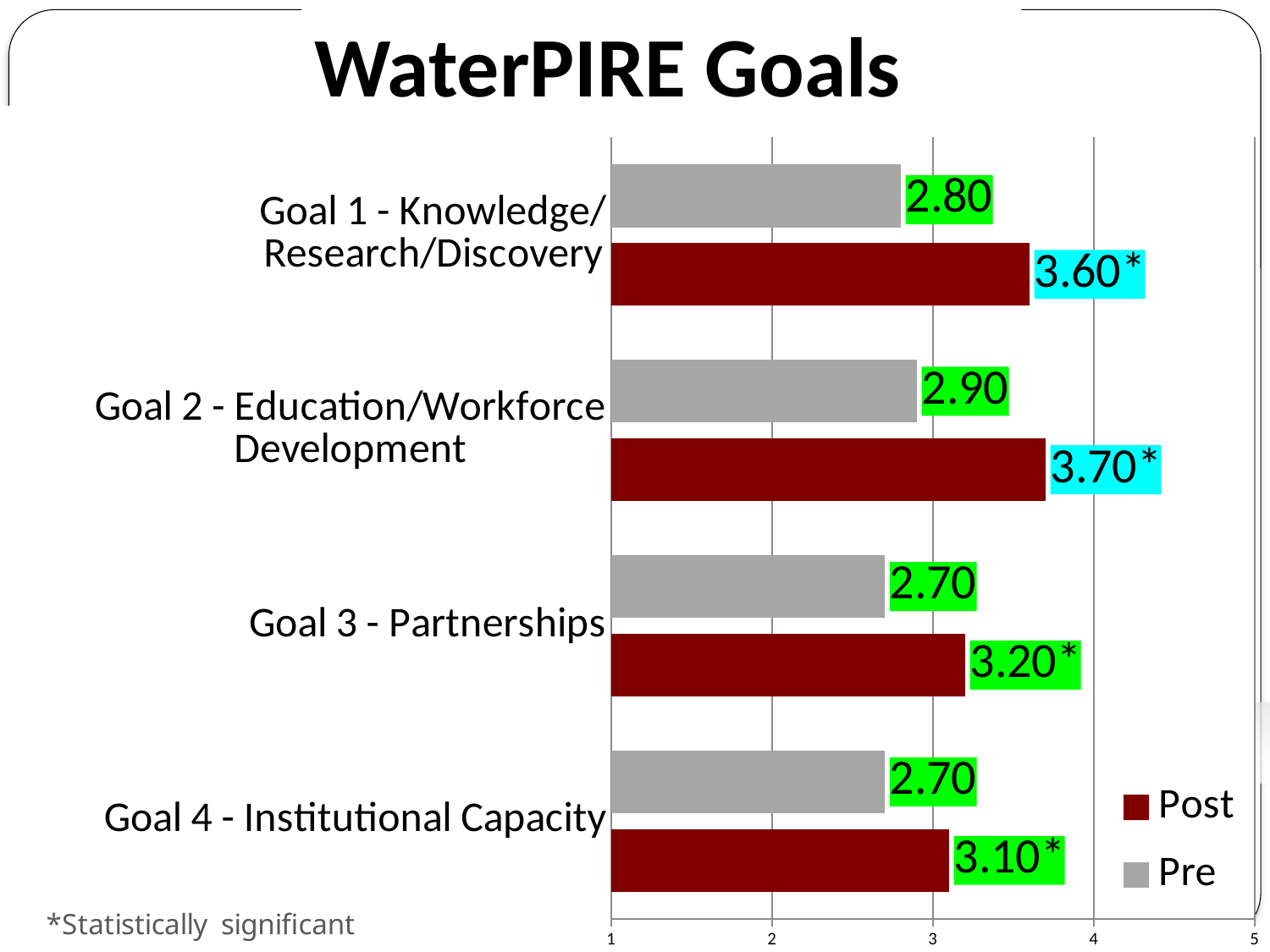
What is the Pre value for Goal 2 - Education/Workforce Development? 2.90 What is the Post value for Goal 4 - Institutional Capacity? 3.10 Which goal has the highest Post value? Goal 2 - Education/Workforce Development How many series does the legend list? 2 What type of chart is shown on the slide? bar chart Which is larger for Goal 2 - Education/Workforce Development, the Pre value or the Post value? Post Is the Pre value for Goal 3 - Partnerships greater or less than 3? less How many goals are shown on the chart? 4 What is the difference between the Post and Pre values for Goal 3 - Partnerships? 0.50 What is the Post value for Goal 1 - Knowledge/Research/Discovery? 3.60 What is the difference between the Post and Pre values for Goal 1 - Knowledge/Research/Discovery? 0.80 Which goal has the lowest Post value? Goal 4 - Institutional Capacity